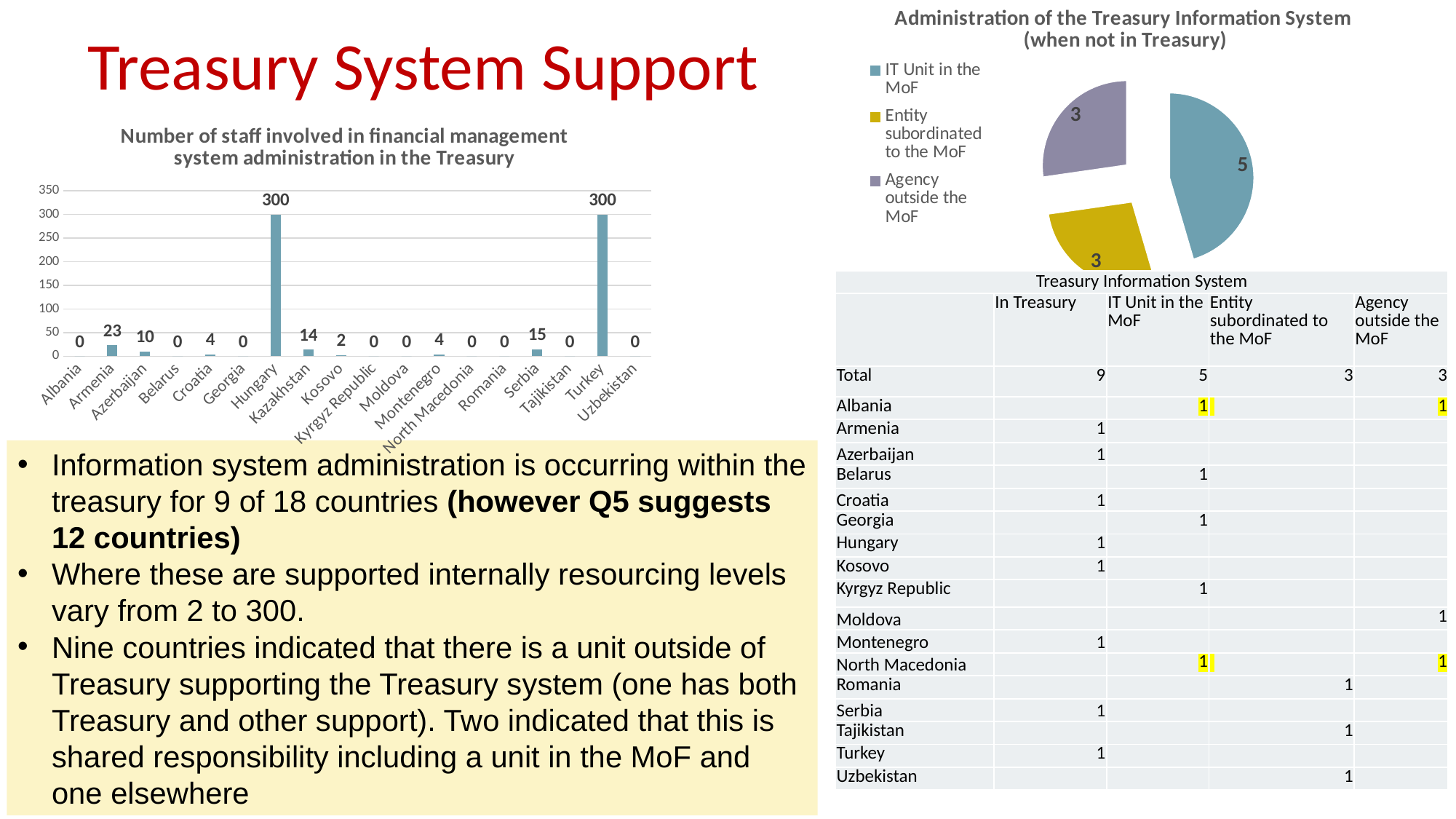
What kind of chart is 'Number of staff involved in financial management system administration in the Treasury'? Bar chart In the bar chart 'Number of staff involved in financial management system administration in the Treasury', which is larger, the value for Serbia or the value for Kazakhstan? Serbia In the bar chart 'Number of staff involved in financial management system administration in the Treasury', what is the value for Kazakhstan? 14 How many countries are shown on the x axis of the bar chart 'Number of staff involved in financial management system administration in the Treasury'? 18 In the bar chart 'Number of staff involved in financial management system administration in the Treasury', what is the value for Armenia? 23 In the bar chart 'Number of staff involved in financial management system administration in the Treasury', what is the difference between the values for Armenia and Azerbaijan? 13 How many categories does the legend of the pie chart 'Administration of the Treasury Information System (when not in Treasury)' list? 3 In the pie chart 'Administration of the Treasury Information System (when not in Treasury)', which category has the largest slice? IT Unit in the MoF In the pie chart 'Administration of the Treasury Information System (when not in Treasury)', what is the value for 'IT Unit in the MoF'? 5 In the bar chart 'Number of staff involved in financial management system administration in the Treasury', what is the value for Serbia? 15 In the pie chart 'Administration of the Treasury Information System (when not in Treasury)', what is the difference between the values for 'IT Unit in the MoF' and 'Agency outside the MoF'? 2 In the bar chart 'Number of staff involved in financial management system administration in the Treasury', which two countries share the highest value? Hungary and Turkey